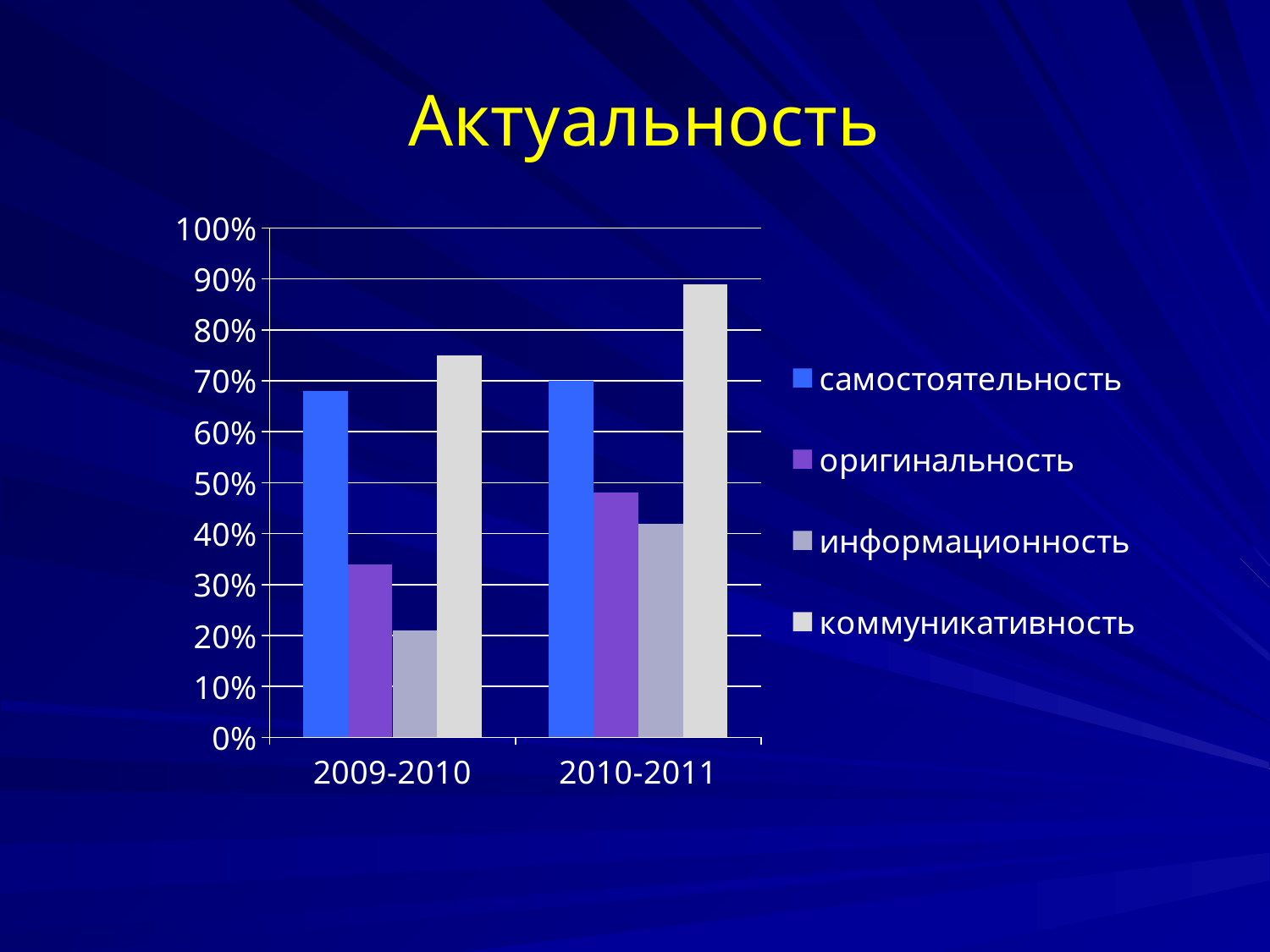
Which is larger: оригинальность in 2009-2010 or оригинальность in 2010-2011? оригинальность in 2010-2011 What is the title of the slide with the chart? Актуальность Which series has the highest value in 2010-2011? коммуникативность Which series has the lowest value in 2009-2010? информационность Is the value for коммуникативность in 2010-2011 greater or less than 80%? greater How many series does the legend list? 4 Which legend entry is shown in the lightest (near-white) colour? коммуникативность How many categories are shown on the x axis? 2 What kind of chart is shown on the slide? bar chart Is the value for оригинальность in 2010-2011 greater or less than 40%? greater Is the value for информационность in 2009-2010 greater or less than 30%? less Does the value for информационность rise or fall from 2009-2010 to 2010-2011? rise